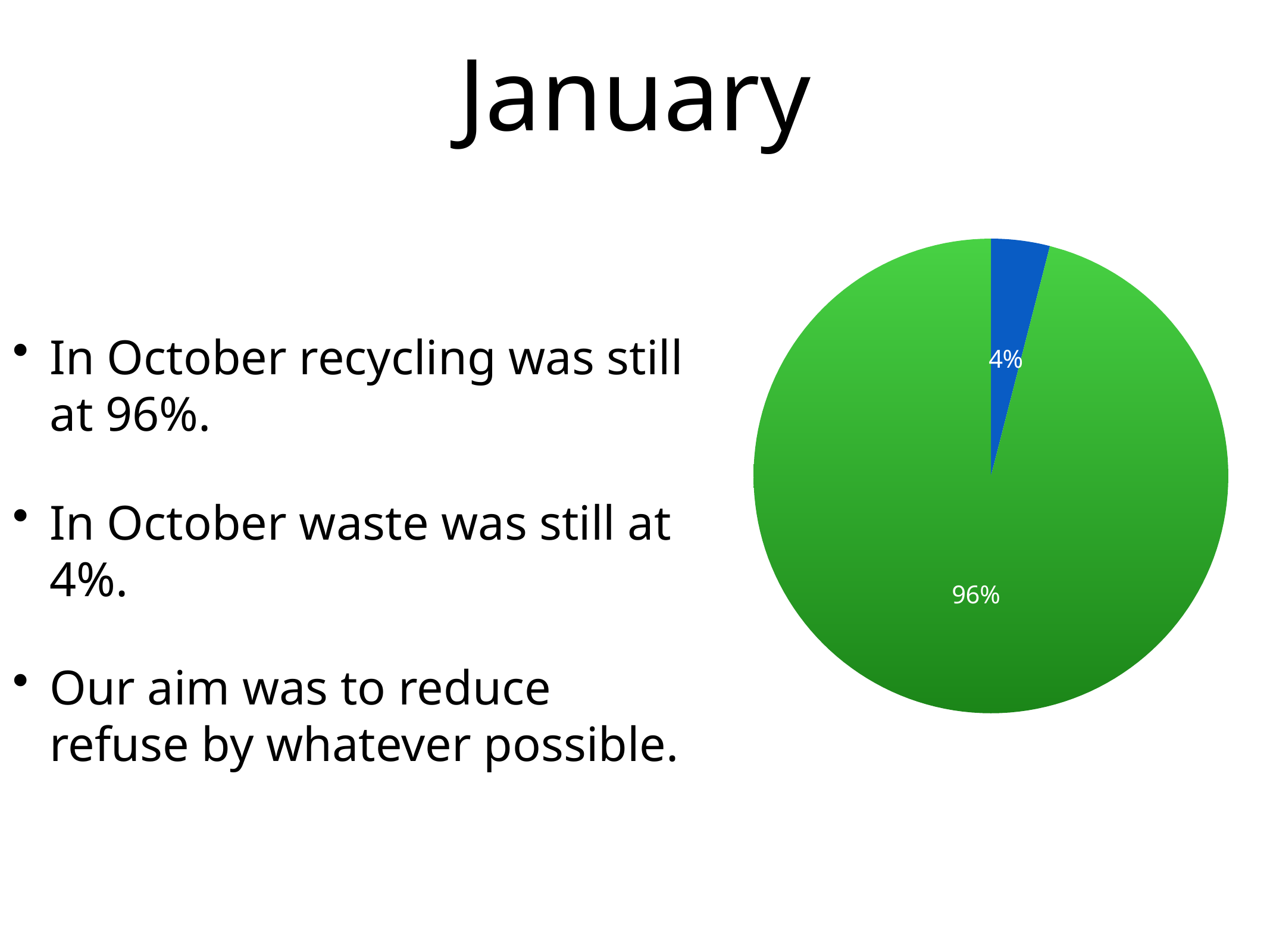
What kind of chart is shown on the slide? pie chart Which slice of the pie chart is the smallest? the blue slice (4%) What percentage is shown on the blue slice of the pie chart? 4% What percentage is shown on the green slice of the pie chart? 96% What is the difference between the two slice values in the pie chart? 92% What colour is the largest slice of the pie chart? green What is the title of the slide containing the pie chart? January What share of the pie does the green slice represent? 96% Is the green slice or the blue slice larger in the pie chart? the green slice How many slices does the pie chart have? 2 Which slice of the pie chart is the largest? the green slice (96%) What share of the pie does the blue slice represent? 4%